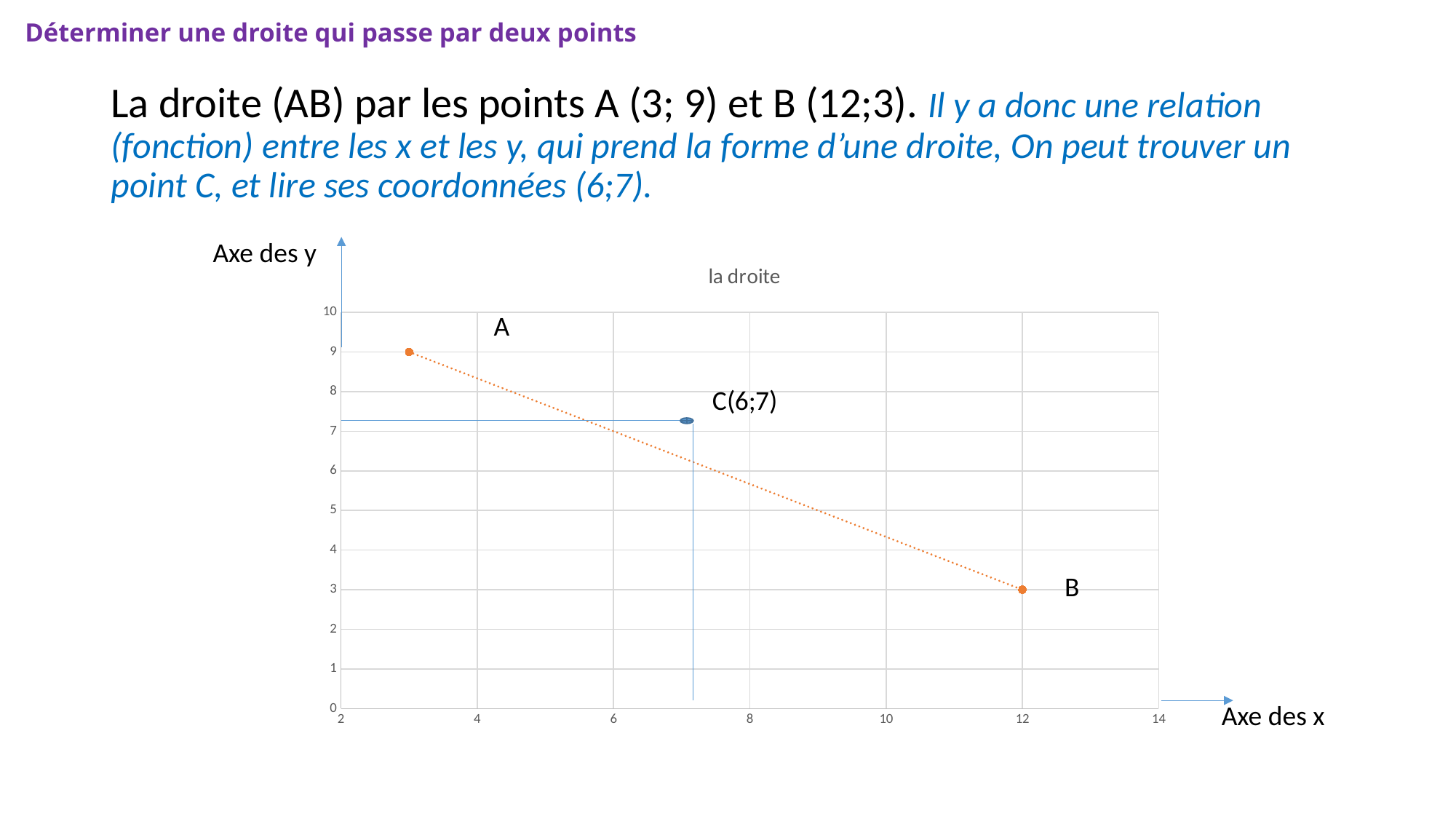
Which point, A or B, has the higher y-value? A What is the title of the chart? la droite Which point has the larger x-value, A or B? B Is the y-value of point C greater or less than 5? greater What kind of chart is shown on the slide? scatter chart Does the dotted line rise or fall as x increases? fall What is the x-value of point B on the chart? 12 What label is given to the horizontal axis? Axe des x What is the y-value of point B on the chart? 3 What is the difference between the y-values of points A and B? 6 What is the y-value of point A on the chart? 9 What are the coordinates of point C as labelled on the chart? (6;7)